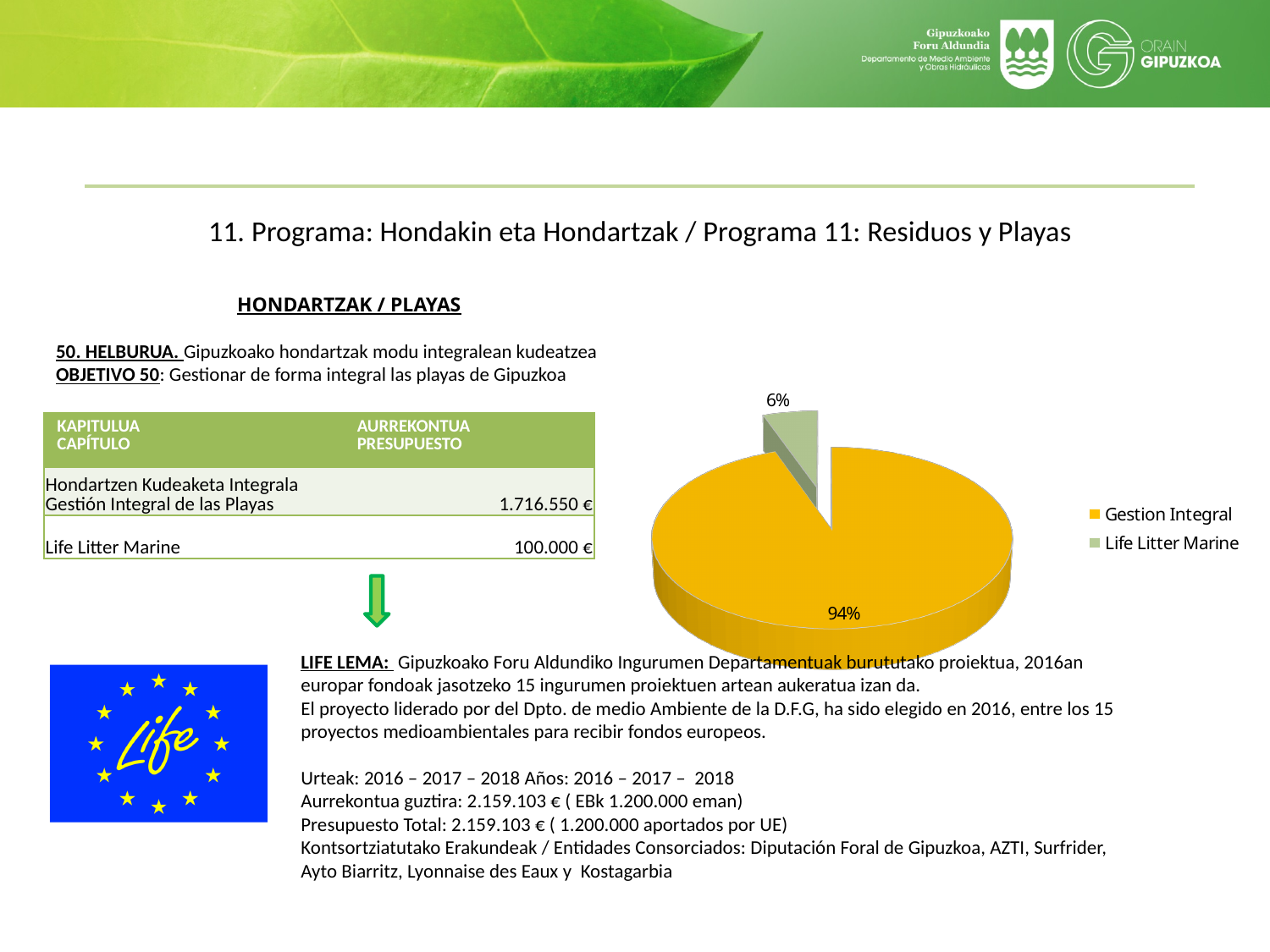
How many entries does the legend of the pie chart list? 2 Which is larger in the pie chart, Gestion Integral or Life Litter Marine? Gestion Integral Which slice of the pie chart is the largest? Gestion Integral How many slices does the pie chart have? 2 What is the difference in percentage points between the Gestion Integral slice and the Life Litter Marine slice? 88 What share of the pie does Life Litter Marine represent? 6% What kind of chart is shown on the slide? pie chart Which slice of the pie chart is the smallest? Life Litter Marine What share of the pie does Gestion Integral represent? 94% Is the share for Life Litter Marine greater or less than 10%? less What colour is the Gestion Integral slice in the pie chart? yellow What is the second entry listed in the pie chart's legend? Life Litter Marine